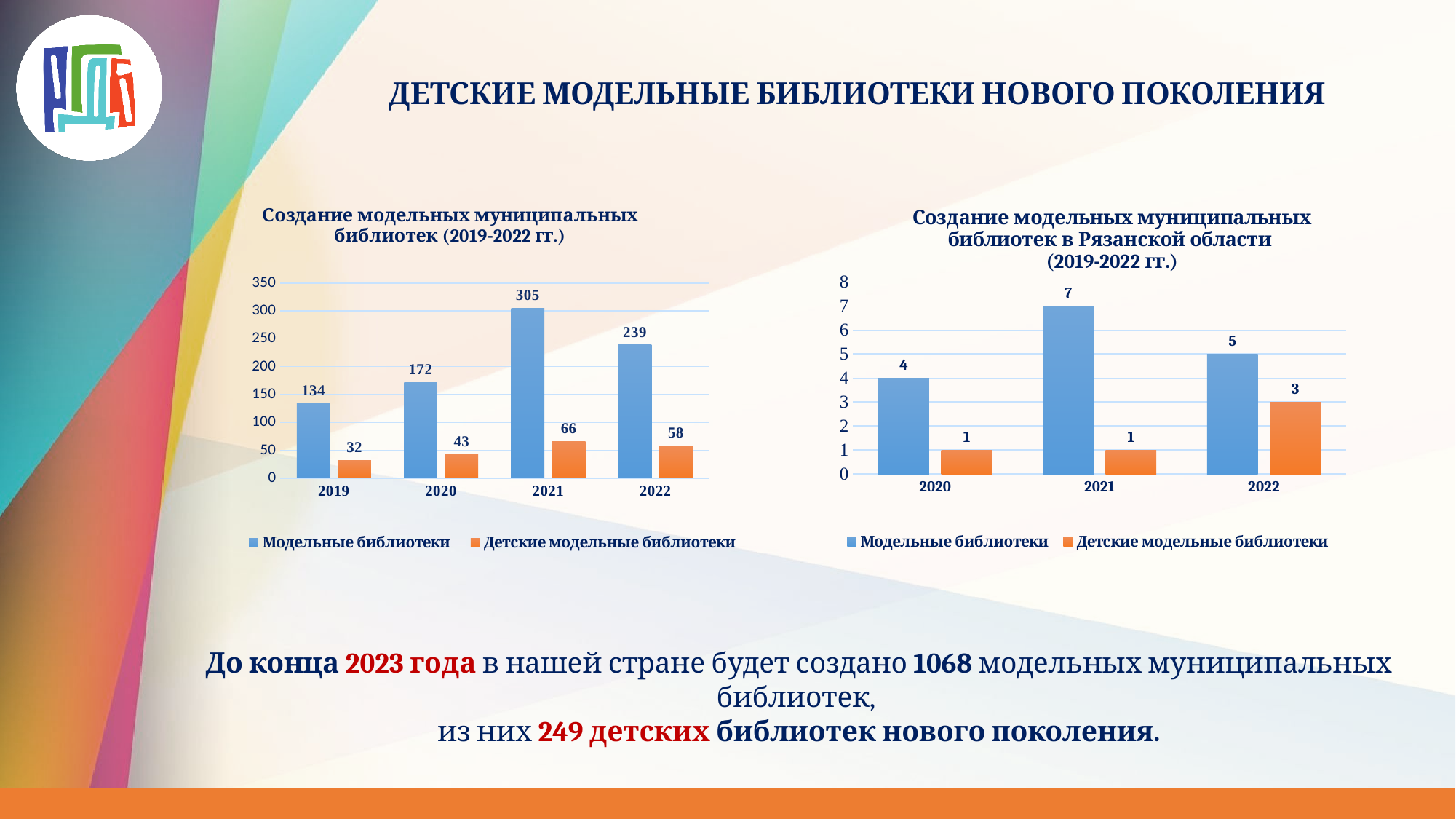
In the left chart (Создание модельных муниципальных библиотек (2019-2022 гг.)), is the value for Модельные библиотеки in 2022 greater or less than 250? less What type of chart is the left chart (Создание модельных муниципальных библиотек (2019-2022 гг.))? Bar chart In the right chart (Создание модельных муниципальных библиотек в Рязанской области), what is the value for Детские модельные библиотеки in 2022? 3 In the left chart (Создание модельных муниципальных библиотек (2019-2022 гг.)), which year has the lowest value for Детские модельные библиотеки? 2019 In the left chart (Создание модельных муниципальных библиотек (2019-2022 гг.)), what is the difference between Модельные библиотеки and Детские модельные библиотеки in 2022? 181 In the left chart (Создание модельных муниципальных библиотек (2019-2022 гг.)), which year has the highest value for Модельные библиотеки? 2021 In the left chart (Создание модельных муниципальных библиотек (2019-2022 гг.)), what is the value for Детские модельные библиотеки in 2020? 43 In the right chart (Создание модельных муниципальных библиотек в Рязанской области), what is the value for Модельные библиотеки in 2021? 7 In the left chart (Создание модельных муниципальных библиотек (2019-2022 гг.)), how many years are shown on the x axis? 4 How many series does the legend of the right chart (Создание модельных муниципальных библиотек в Рязанской области) list? 2 In the left chart (Создание модельных муниципальных библиотек (2019-2022 гг.)), what is the value for Модельные библиотеки in 2021? 305 In the right chart (Создание модельных муниципальных библиотек в Рязанской области), which is larger in 2020: Модельные библиотеки or Детские модельные библиотеки? Модельные библиотеки